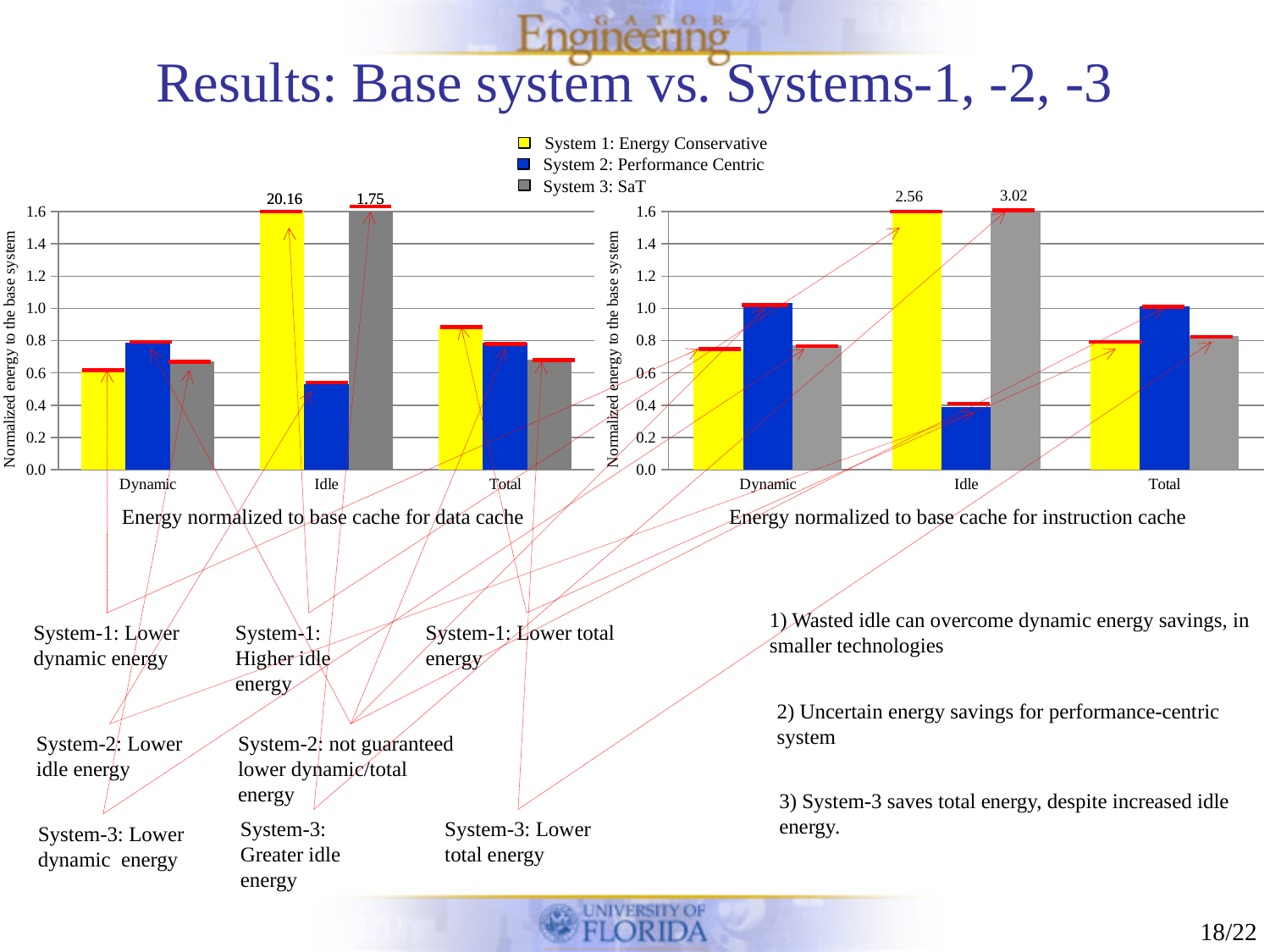
In the chart titled 'Energy normalized to base cache for data cache', what is the difference between the Idle values for System 1 and System 3? 18.41 In the chart titled 'Energy normalized to base cache for instruction cache', what is the difference between the Idle values for System 3 and System 1? 0.46 In the chart titled 'Energy normalized to base cache for data cache', what is the value for System 1 in the Idle category? 20.16 How many series does the shared legend list for the charts on this slide? 3 In the chart titled 'Energy normalized to base cache for instruction cache', which has the larger Idle value, System 1 or System 3? System 3 In the chart titled 'Energy normalized to base cache for instruction cache', what is the value for System 1 in the Idle category? 2.56 In the chart titled 'Energy normalized to base cache for data cache', which system has the highest value in the Idle category? System 1 In the chart titled 'Energy normalized to base cache for instruction cache', is the Idle value for System 2 greater or less than 0.6? less In the chart titled 'Energy normalized to base cache for data cache', is the Dynamic value for System 1 greater or less than 0.8? less In the chart titled 'Energy normalized to base cache for instruction cache', what is the value for System 3 in the Idle category? 3.02 What kind of chart is 'Energy normalized to base cache for instruction cache'? bar chart In the chart titled 'Energy normalized to base cache for data cache', what is the value for System 3 in the Idle category? 1.75